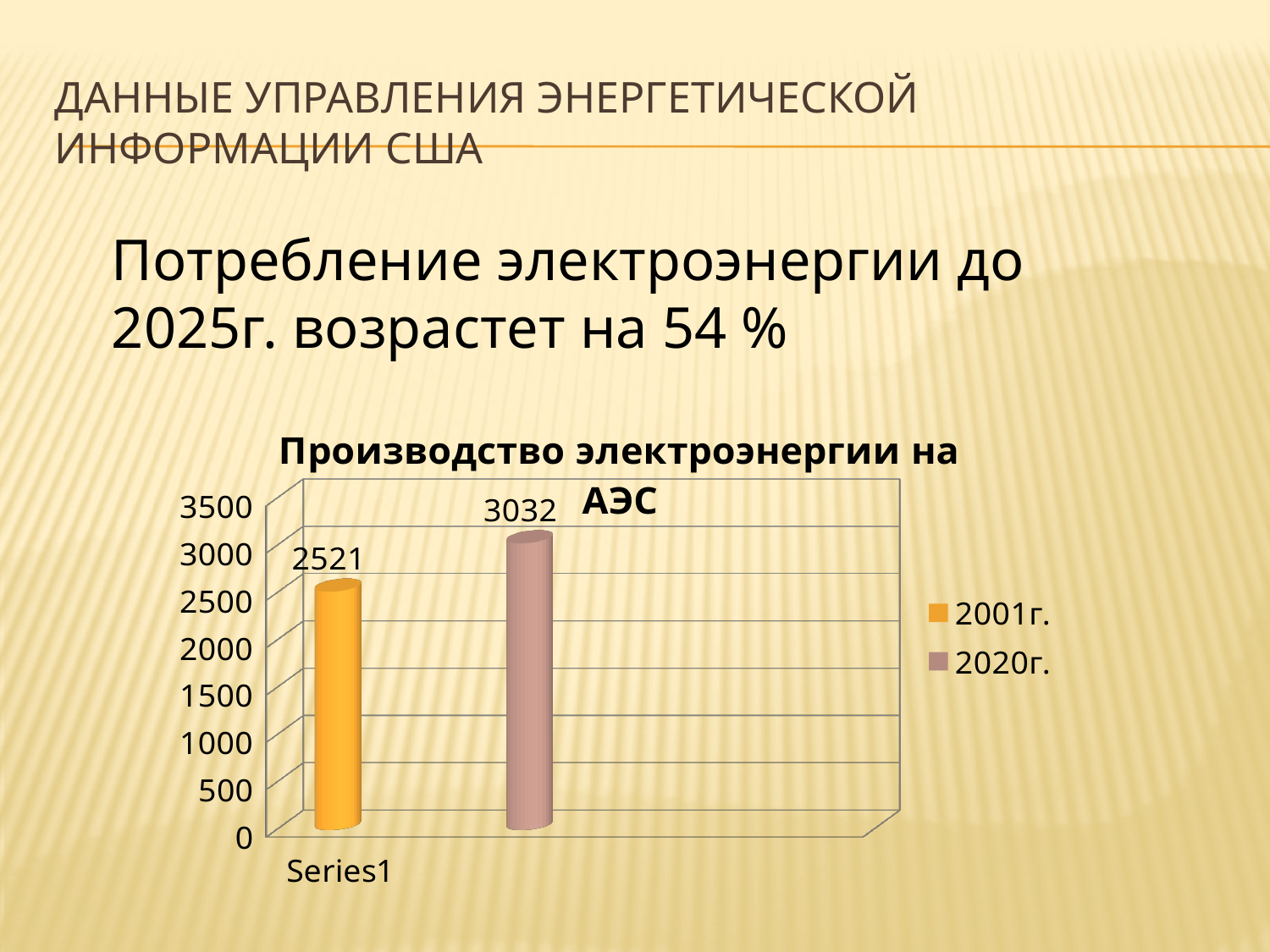
Which series has the higher value, 2001г. or 2020г.? 2020г. What is the difference between the 2020г. value and the 2001г. value? 511 Is the value for 2001г. greater or less than 3000? less What kind of chart is shown on the slide? bar chart What is the value for 2020г. in the chart? 3032 Which series has the highest value in the chart? 2020г. Is the value for 2020г. greater or less than 3000? greater What is the title of the chart? Производство электроэнергии на АЭС What is the maximum value shown on the vertical axis of the chart? 3500 Which series has the lowest value in the chart? 2001г. What is the value for 2001г. in the chart? 2521 How many series does the legend list? 2